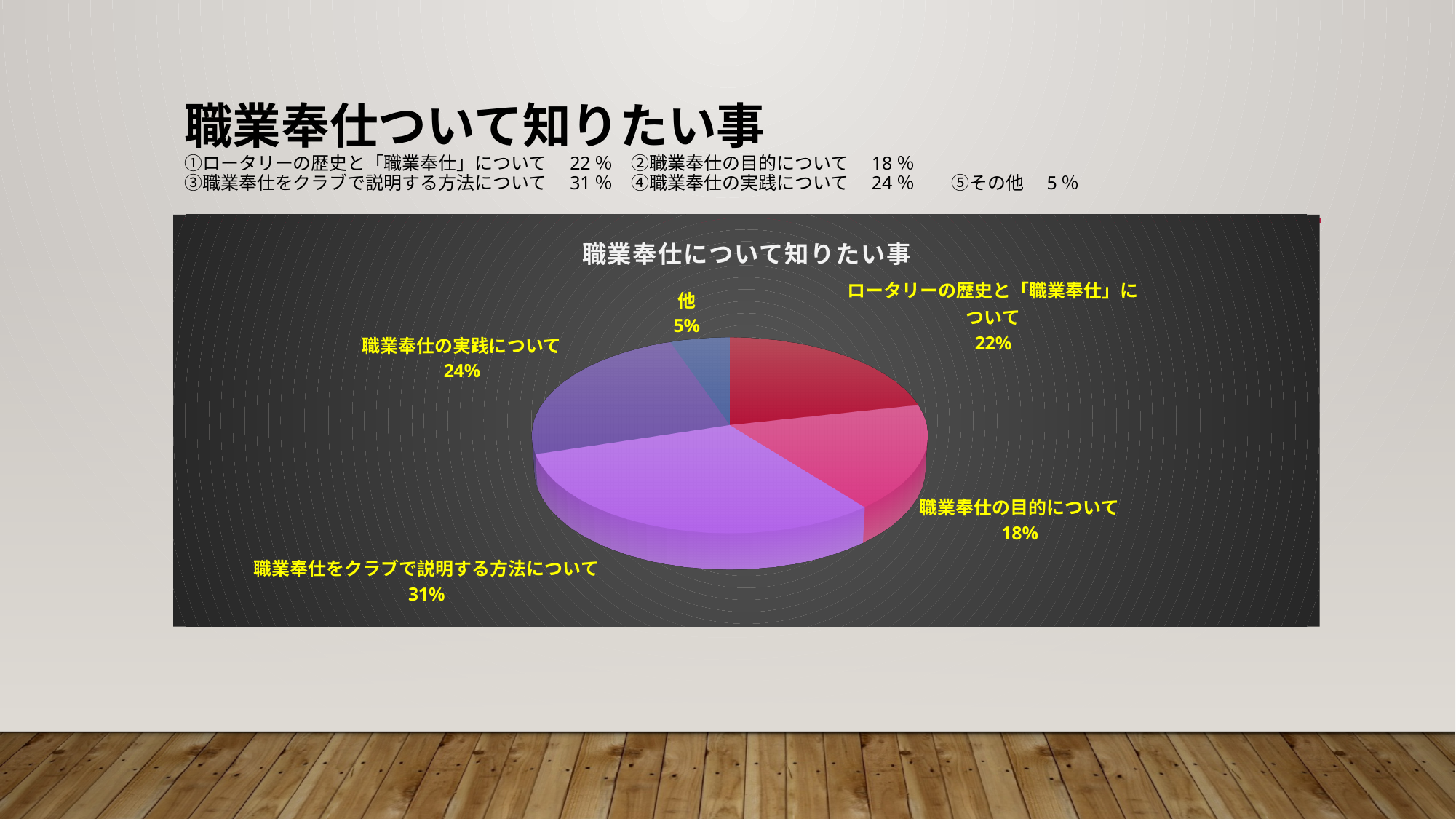
What percentage is shown for 職業奉仕の目的について? 18% Which is larger, the share for 職業奉仕の実践について or the share for ロータリーの歴史と「職業奉仕」について? 職業奉仕の実践について What percentage is shown for 職業奉仕の実践について? 24% What percentage is shown for 職業奉仕をクラブで説明する方法について? 31% What is the difference in percentage points between 職業奉仕をクラブで説明する方法について and 職業奉仕の目的について? 13 Which category has the smallest share of the pie? 他 What percentage is shown for 他? 5% Which category has the largest share of the pie? 職業奉仕をクラブで説明する方法について What is the title of the chart? 職業奉仕について知りたい事 What percentage is shown for ロータリーの歴史と「職業奉仕」について? 22% What type of chart is shown on the slide? Pie chart How many slices does the pie chart have? 5